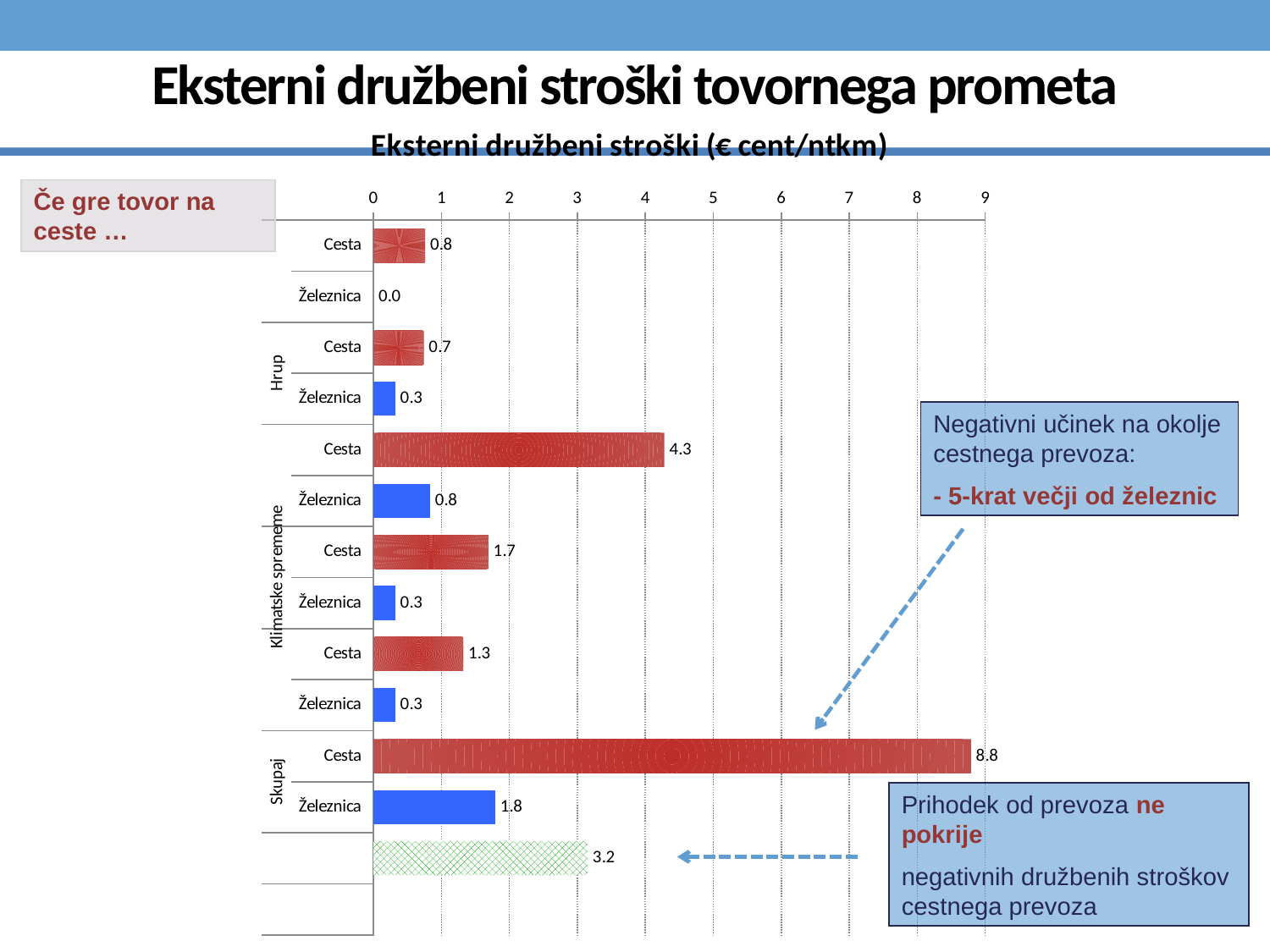
What is the highest value shown on the horizontal axis? 9 In the Hrup group, which is larger, Cesta or Železnica? Cesta What is the value for Cesta in the Hrup group? 0.7 What is the value for Železnica in the Skupaj group? 1.8 What type of chart is shown on the slide? Bar chart What is the title of the chart? Eksterni družbeni stroški (€ cent/ntkm) What is the value for Železnica in the Hrup group? 0.3 What is the value of the green hatched bar at the bottom of the chart? 3.2 What is the value for Cesta in the Skupaj group? 8.8 Is the value for Cesta in the Skupaj group greater or less than 8? greater Which bar has the highest value in the chart? Cesta in the Skupaj group (8.8) What is the difference between the Cesta and Železnica values in the Skupaj group? 7.0